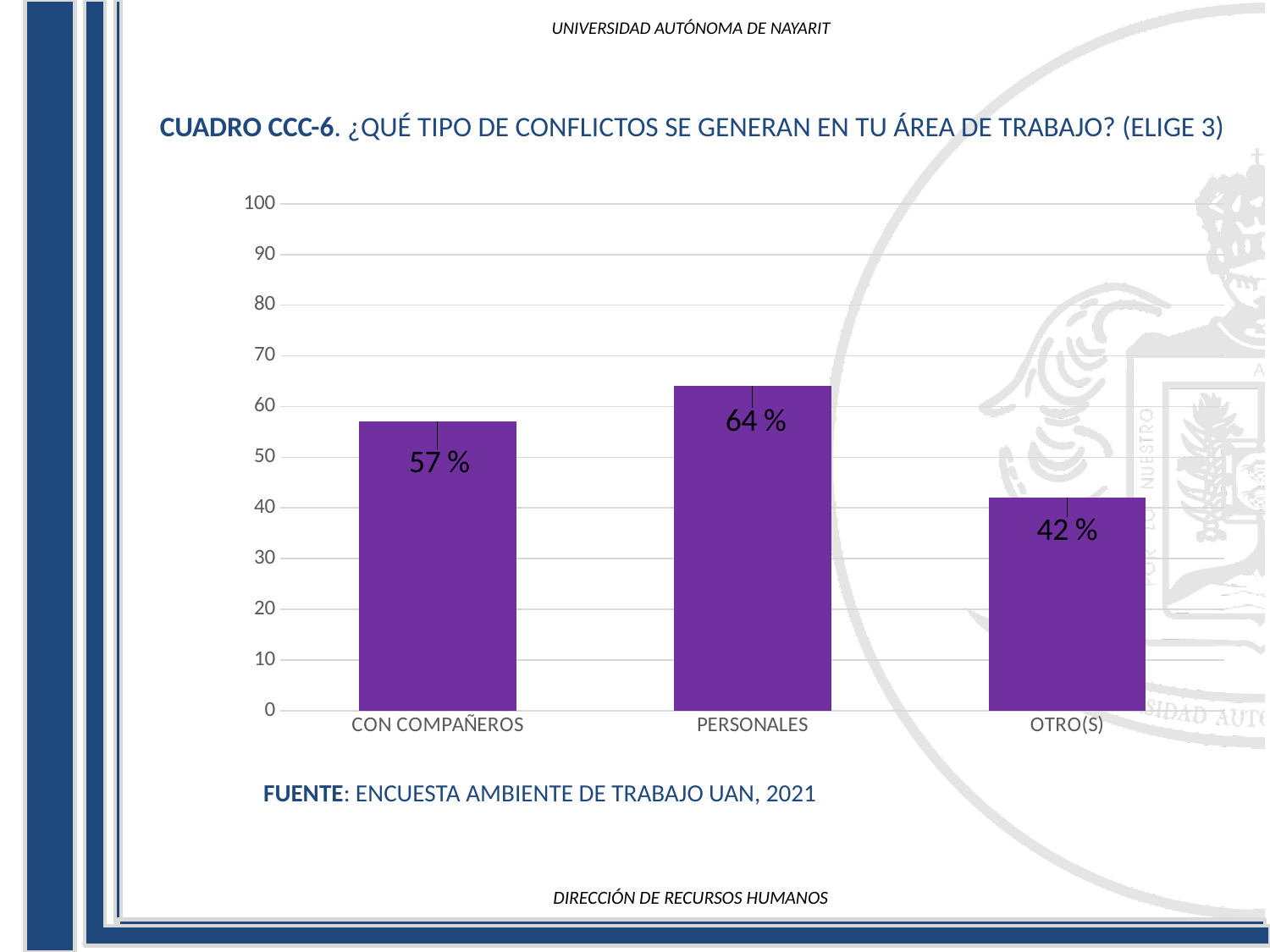
What kind of chart is shown on the slide? bar chart What is the value for PERSONALES? 64 % What is the value for CON COMPAÑEROS? 57 % What is the difference between the values for CON COMPAÑEROS and OTRO(S)? 15 % What source is cited below the chart? ENCUESTA AMBIENTE DE TRABAJO UAN, 2021 How many categories are shown on the chart? 3 Which category has the lowest value? OTRO(S) What is the difference between the values for PERSONALES and CON COMPAÑEROS? 7 % Which category has the highest value? PERSONALES Which is larger, the value for CON COMPAÑEROS or the value for OTRO(S)? CON COMPAÑEROS Is the value for PERSONALES greater or less than 60? greater What is the value for OTRO(S)? 42 %